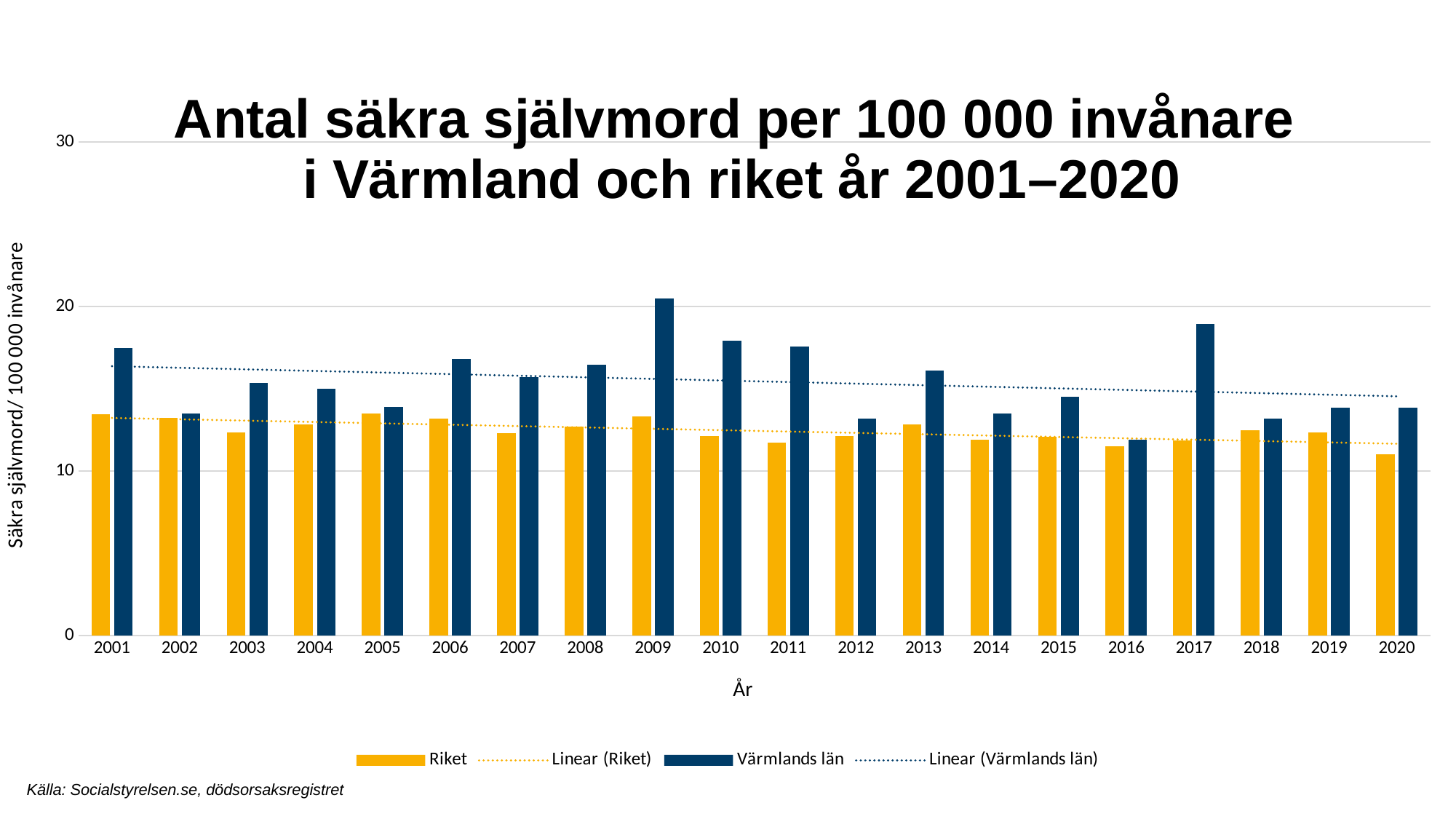
What colour are the bars for Värmlands län? dark blue In which year is the value for Värmlands län highest? 2009 Does the dotted linear trend line for Riket rise or fall from 2001 to 2020? fall In 2009, which is larger: the value for Riket or for Värmlands län? Värmlands län In which year is the value for Värmlands län lowest? 2016 Is the value for Värmlands län in 2009 greater or less than 20? greater Is the value for Värmlands län in 2017 greater or less than 20? less How many entries does the legend list? 4 What kind of chart is shown on the slide? bar chart Is the value for Riket in 2020 greater or less than 10? greater In which year is the value for Riket lowest? 2020 How many years are shown on the x axis? 20